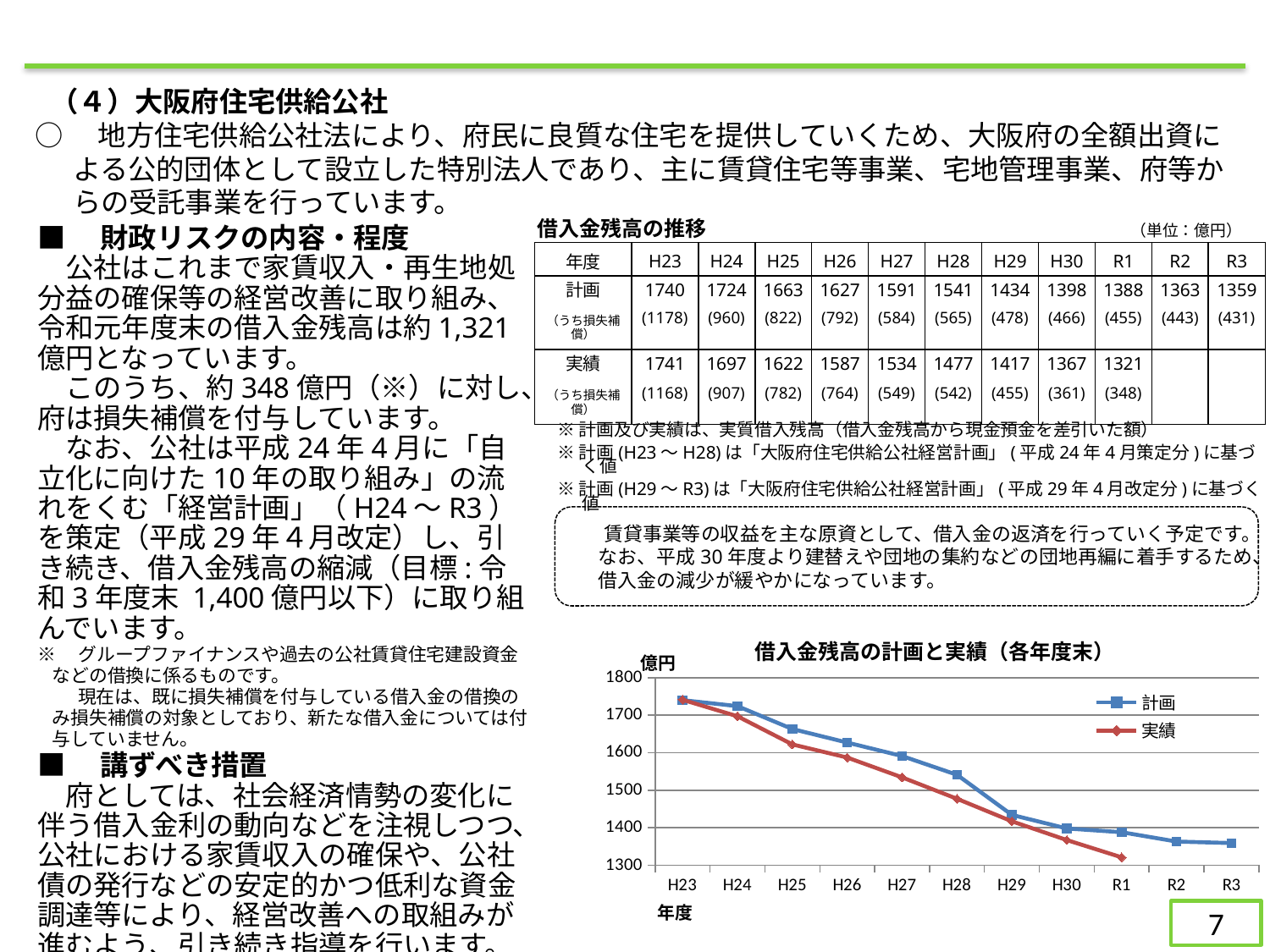
In the chart 借入金残高の計画と実績（各年度末）, is the 計画 value for H23 greater or less than 1700? greater In the chart 借入金残高の計画と実績（各年度末）, which fiscal year has the lowest 計画 value? R3 In the chart 借入金残高の計画と実績（各年度末）, which series is higher at H27, 計画 or 実績? 計画 In the chart 借入金残高の計画と実績（各年度末）, do the 計画 values rise or fall from H23 to R3? fall What are the two legend entries in the chart 借入金残高の計画と実績（各年度末）? 計画 and 実績 How many series does the legend of the chart 借入金残高の計画と実績（各年度末） list? 2 According to the slide, what is the 実績 borrowing balance for R1 (in 億円)? 1321 According to the slide, what is the 計画 borrowing balance for R3 (in 億円)? 1359 What kind of chart is shown under the title 借入金残高の計画と実績（各年度末）? line chart According to the slide, what is the difference between the 計画 and 実績 borrowing balances for H28 (in 億円)? 64 How many fiscal years are shown on the x axis of the chart 借入金残高の計画と実績（各年度末）? 11 In the chart 借入金残高の計画と実績（各年度末）, is the 実績 value for R1 greater or less than 1400? less